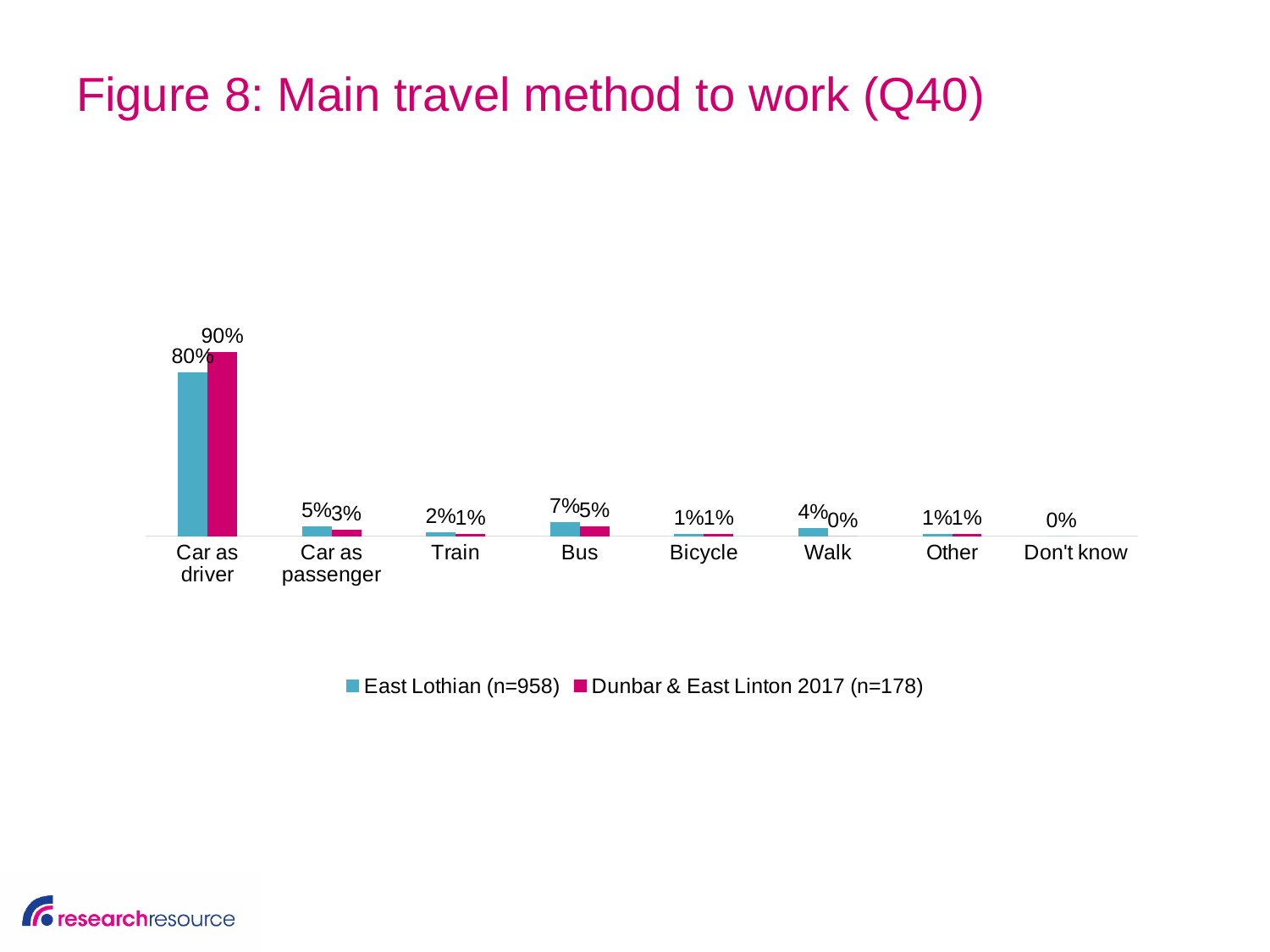
How many series does the legend list? 2 What percentage of East Lothian respondents travel to work as a car driver? 80% What is the sample size (n) for the Dunbar & East Linton 2017 series shown in the legend? 178 What is the value for Bus in the East Lothian series? 7% What percentage of Dunbar & East Linton 2017 respondents travel to work as a car driver? 90% What is the difference between the Dunbar & East Linton 2017 and East Lothian values for Car as driver? 10% What is the value for Walk in the Dunbar & East Linton 2017 series? 0% How many travel method categories are shown on the x axis? 8 What is the difference between the East Lothian and Dunbar & East Linton 2017 values for Car as passenger? 2% What kind of chart is shown on the slide? Bar chart Which travel method has the highest value for East Lothian? Car as driver For Bus, which series has the larger value: East Lothian or Dunbar & East Linton 2017? East Lothian